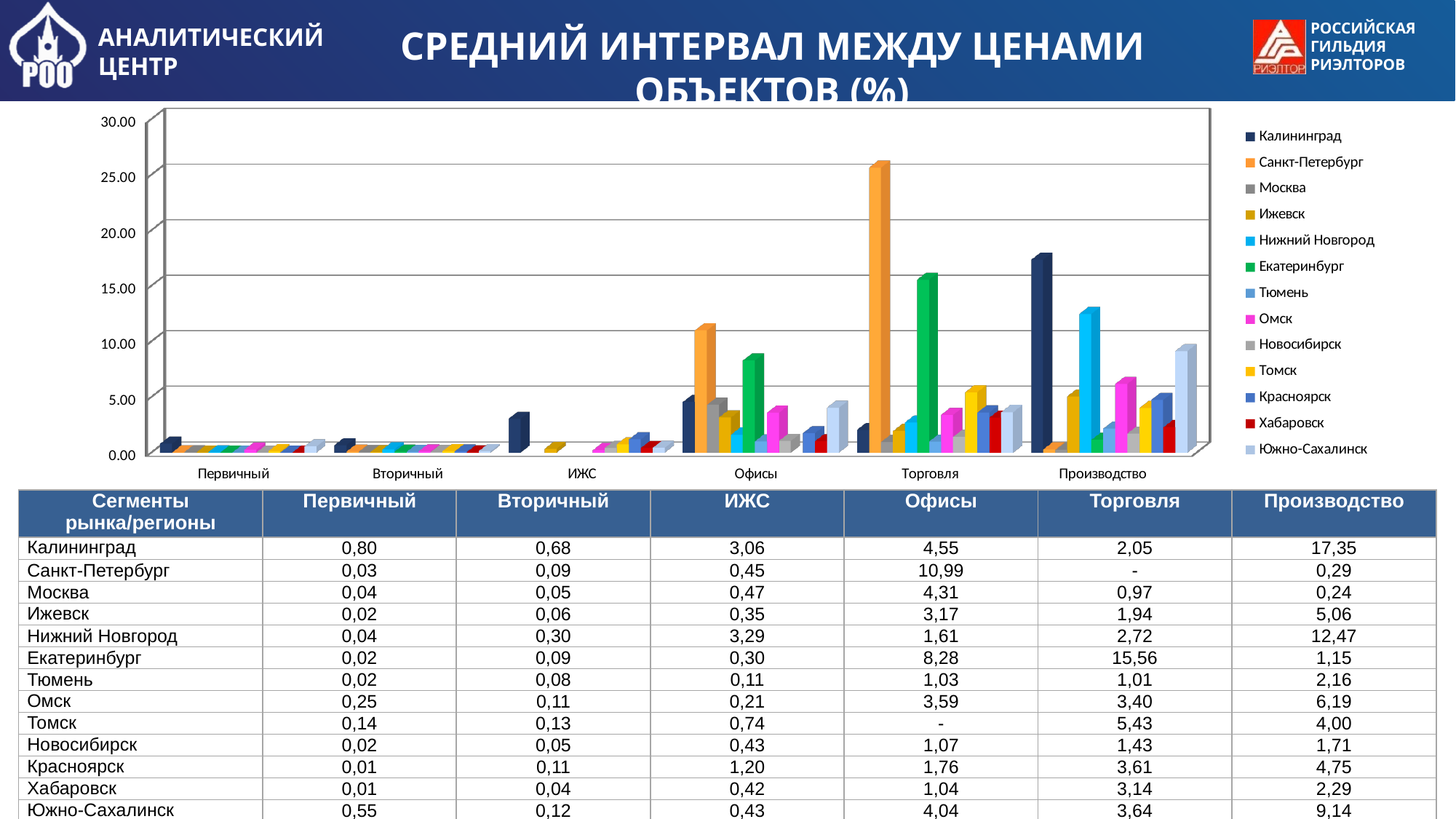
What is the value for Калининград in the Производство category? 17,35 What kind of chart is shown on the slide? bar chart What is the difference between the Производство values for Калининград and Нижний Новгород? 4,88 Which region has the highest value in the Производство category? Калининград Which region has the highest value in the Торговля category? Санкт-Петербург How many market segment categories are shown along the x axis of the chart? 6 What is the value for Санкт-Петербург in the Офисы category? 10,99 How many series (regions) does the chart legend list? 13 Is the value for Санкт-Петербург in the Торговля category greater or less than 20.00? greater Which region is represented by the orange bars in the chart? Санкт-Петербург Which is larger in the Офисы category: the value for Екатеринбург or the value for Москва? Екатеринбург What is the value for Екатеринбург in the Торговля category? 15,56